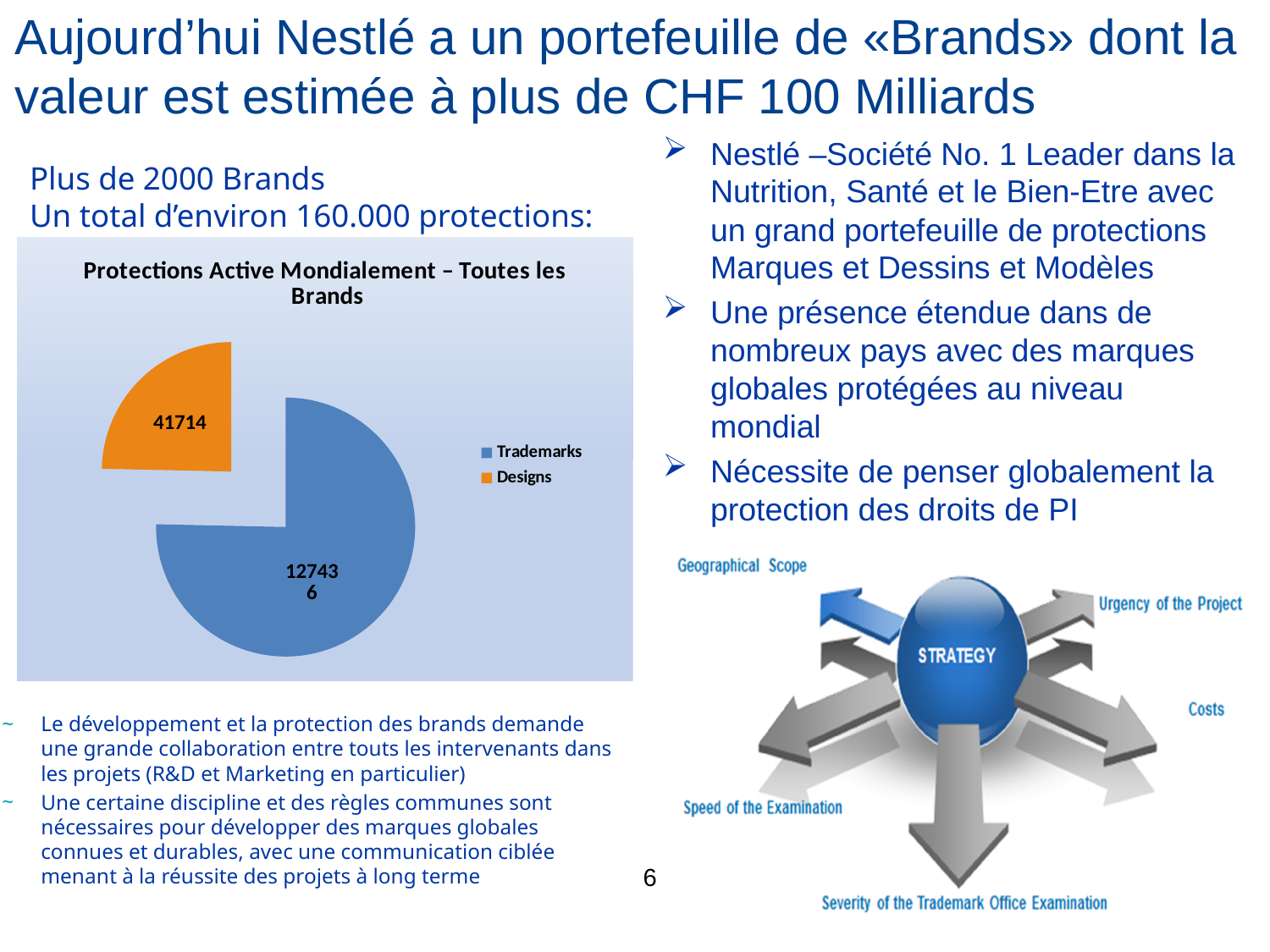
What is the total of the two values shown in the pie chart? 169150 Which category has the smallest slice in the pie chart? Designs How many entries does the legend of the pie chart list? 2 How many slices does the pie chart "Protections Active Mondialement – Toutes les Brands" have? 2 What is the value shown for Designs in the pie chart? 41714 Which category has the largest slice in the pie chart? Trademarks What kind of chart is shown under the title "Protections Active Mondialement – Toutes les Brands"? pie chart What is the difference between the Trademarks value and the Designs value in the pie chart? 85722 What colour is the Designs slice in the pie chart? orange What is the value shown for Trademarks in the pie chart? 127436 In the pie chart, which is larger: Trademarks or Designs? Trademarks What is the title of the pie chart on the slide? Protections Active Mondialement – Toutes les Brands